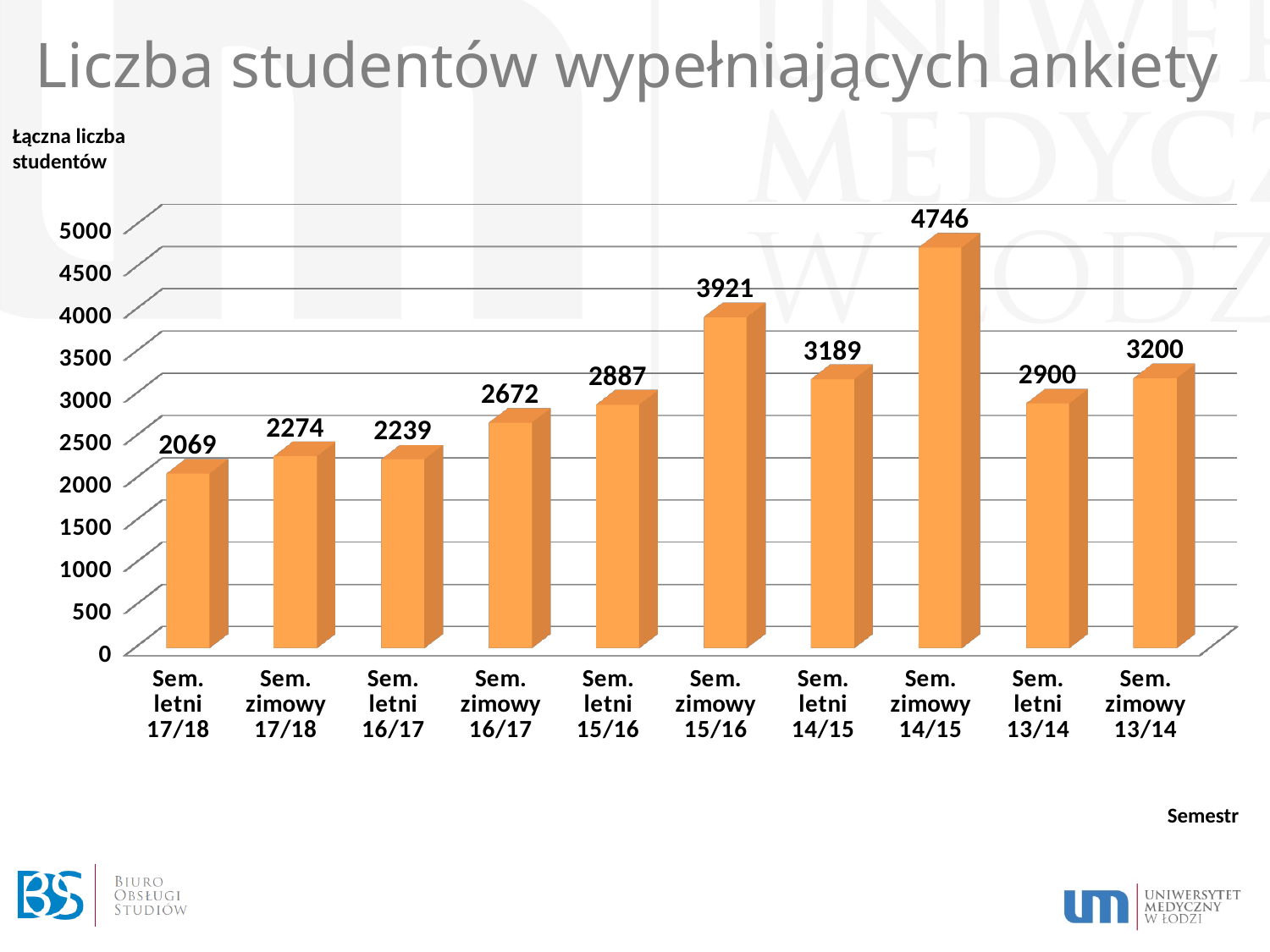
Which semester has the lowest number of students? Sem. letni 17/18 Which is larger, Sem. zimowy 16/17 or Sem. letni 15/16? Sem. letni 15/16 What is the difference between Sem. zimowy 14/15 and Sem. letni 14/15? 1557 What is the value for Sem. zimowy 14/15? 4746 What is the value for Sem. zimowy 15/16? 3921 What is the value for Sem. letni 17/18? 2069 Is the value for Sem. letni 14/15 greater or less than 3000? greater What is the title of the chart? Liczba studentów wypełniających ankiety What kind of chart is shown on the slide? bar chart How many semesters are shown on the x axis? 10 What is the difference between Sem. zimowy 13/14 and Sem. letni 13/14? 300 Which semester has the highest number of students? Sem. zimowy 14/15